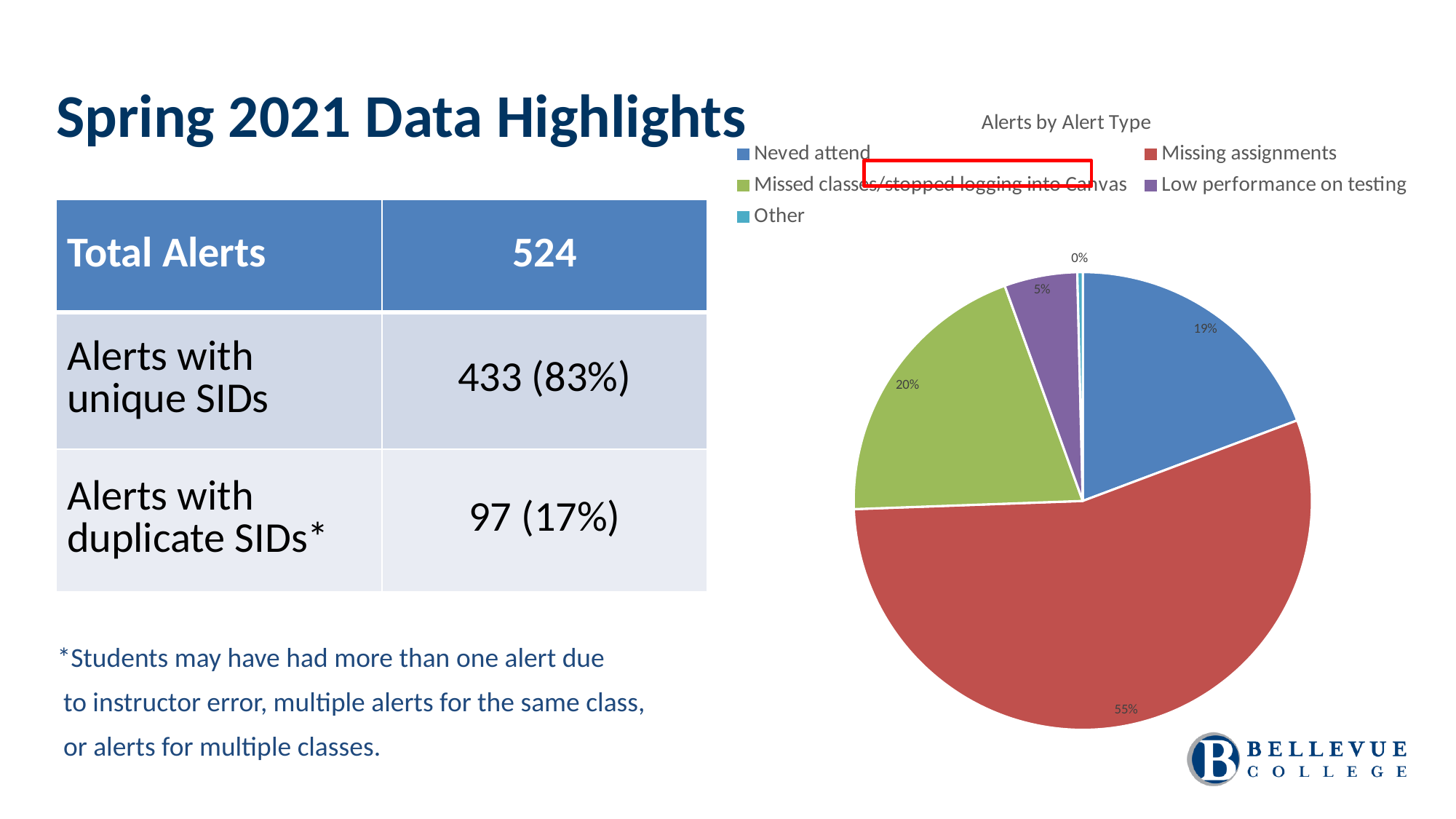
What type of chart is shown on the slide? pie chart What share of the pie does Neved attend represent? 19% What is the difference in percentage points between Missing assignments and Neved attend? 36 Which alert type has the largest share of the pie? Missing assignments What share of the pie does Missing assignments represent? 55% Which colour represents Low performance on testing in the pie chart? purple How many categories does the legend of the pie chart list? 5 What share of the pie does Other represent? 0% What is the title of the chart? Alerts by Alert Type Which alert type has the smallest share of the pie? Other